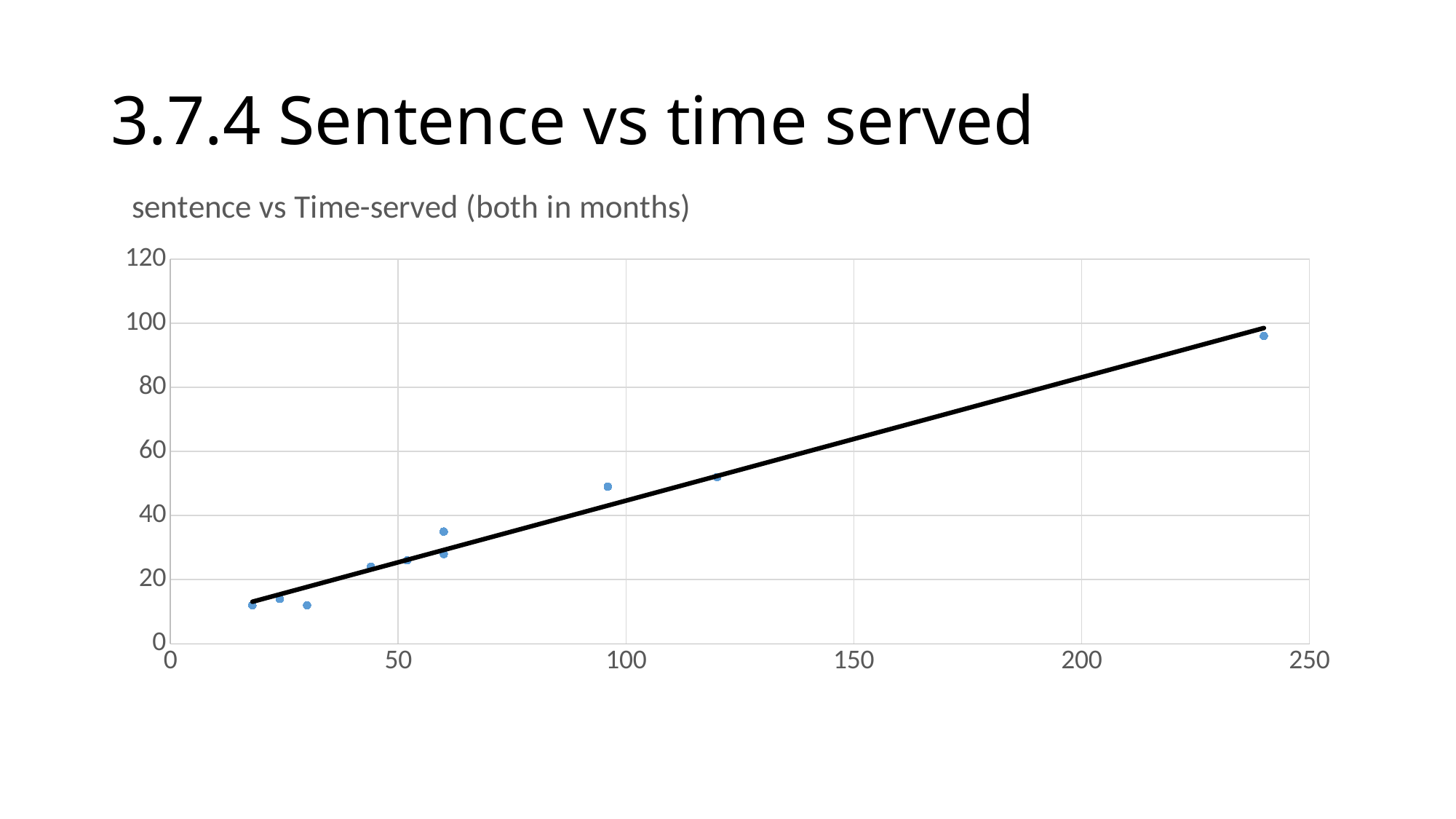
Are the values of the data points near x = 20 greater or less than 20? less Is the value of the data point near x = 120 greater or less than 60? less Do the plotted values rise or fall as the x-axis value increases? rise Is the value of the data point near x = 96 greater or less than 40? greater What is the title of the chart? sentence vs Time-served (both in months) What kind of chart is shown on the slide? scatter chart Which data point has the highest value: the one near x = 240 or the one near x = 120? the one near x = 240 What is the maximum value shown on the vertical axis? 120 Which data point has the highest plotted value? the point near x = 240 How many data points are plotted on the chart? 10